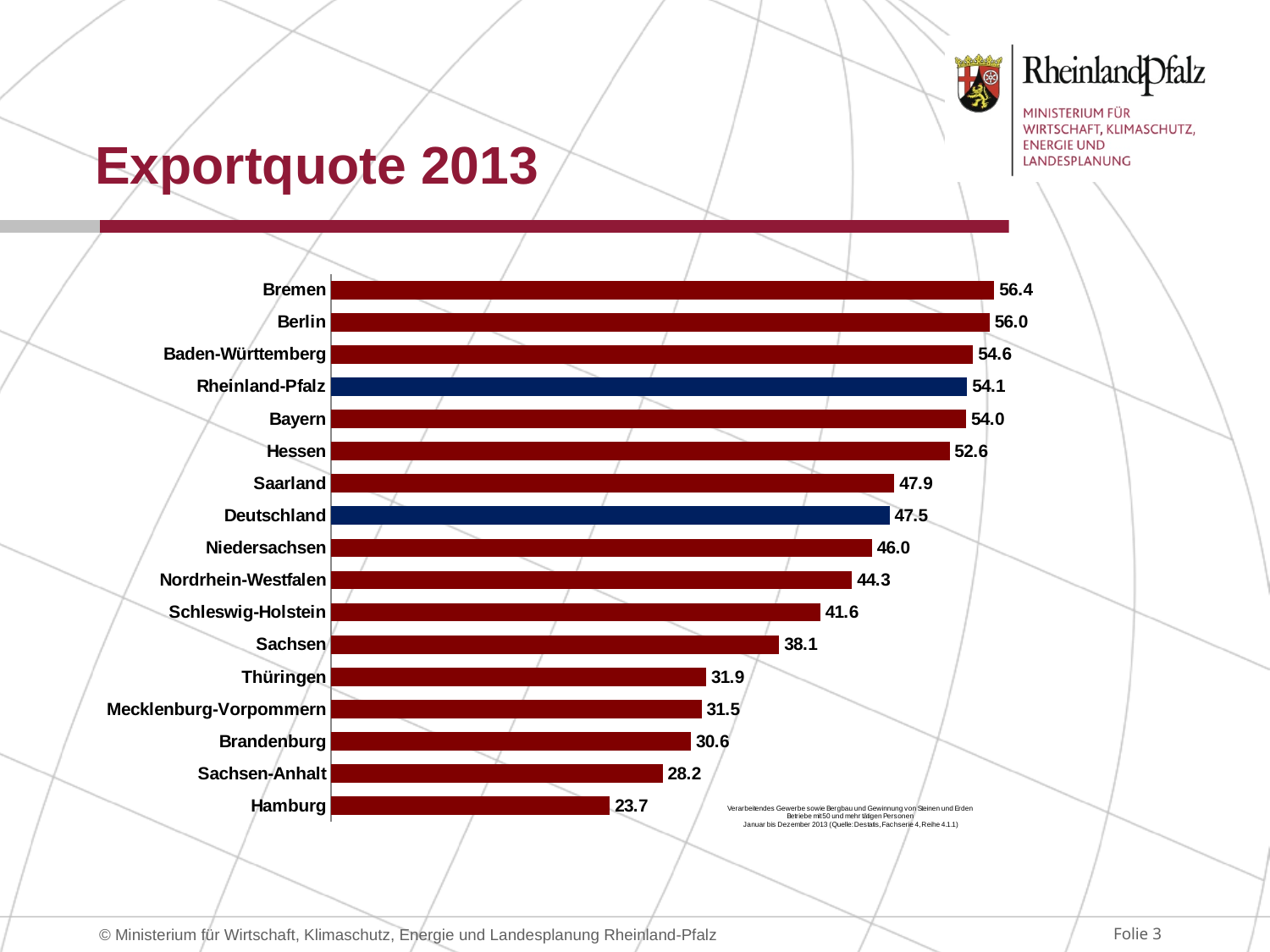
Which has a larger value, Thüringen or Brandenburg? Thüringen What is the difference between the values for Bremen and Hamburg? 32.7 Which two bars are coloured dark blue instead of dark red? Rheinland-Pfalz and Deutschland How many categories (bars) are shown in the chart? 17 Which has a larger value, Niedersachsen or Nordrhein-Westfalen? Niedersachsen What is the value shown for Sachsen? 38.1 What is the export quota value shown for Rheinland-Pfalz? 54.1 What is the value shown for Deutschland? 47.5 What kind of chart is shown on the slide? Bar chart Which category has the lowest value? Hamburg What is the difference between the values for Rheinland-Pfalz and Deutschland? 6.6 Which category has the highest value? Bremen